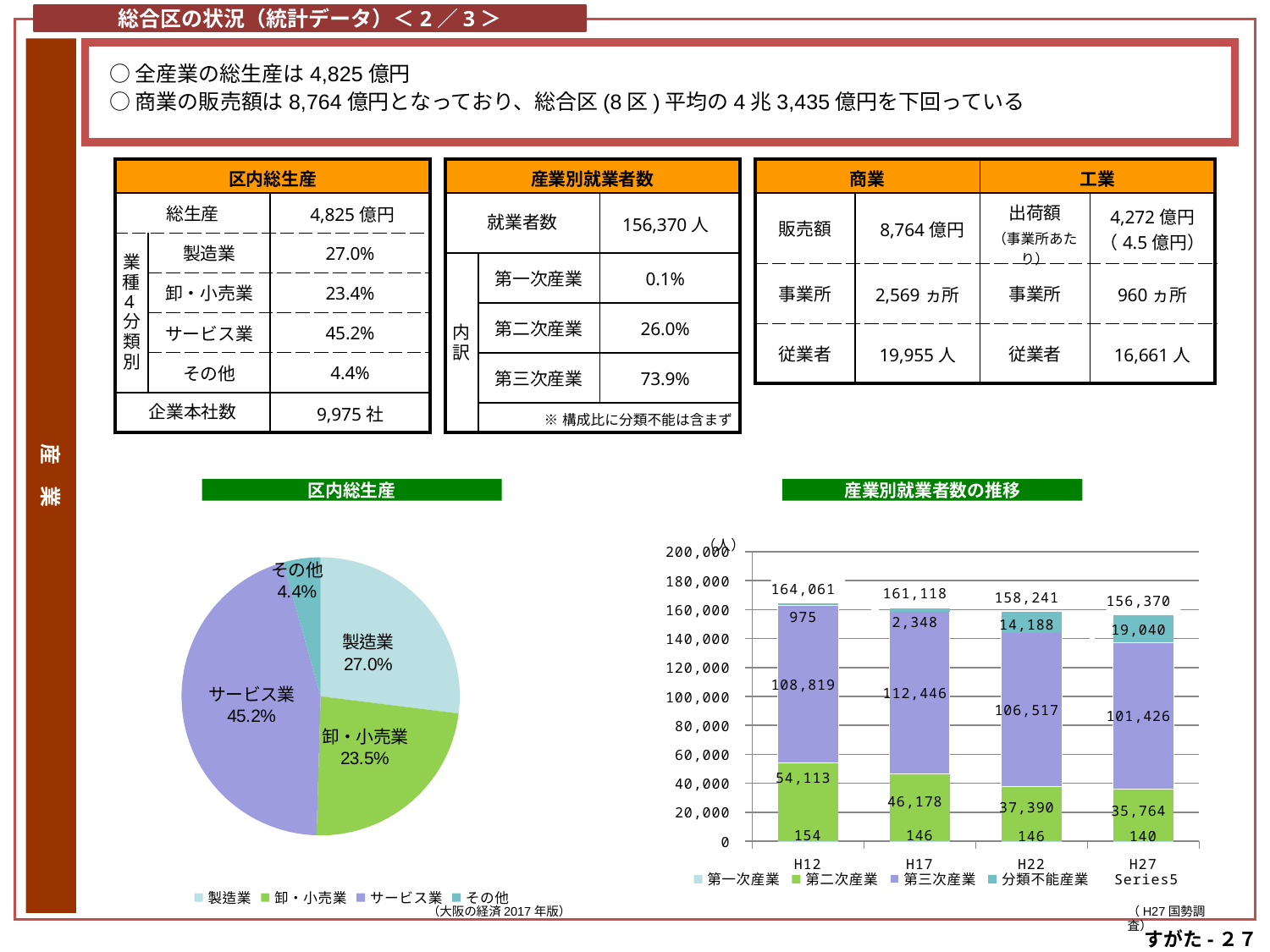
What kind of chart is the 区内総生産 chart? Pie chart In the 区内総生産 pie chart, what share does 卸・小売業 have? 23.5% In the 区内総生産 pie chart, how many slices are there? 4 How many series does the legend of the 産業別就業者数の推移 chart list? 5 In the 区内総生産 pie chart, which category has the largest share? サービス業 In the 産業別就業者数の推移 chart, which year has the highest total? H12 In the 産業別就業者数の推移 chart, do the totals rise or fall from H12 to H27? Fall In the 産業別就業者数の推移 chart, what is the total for H22? 158,241 In the 産業別就業者数の推移 chart, what is the difference between the 第二次産業 values for H12 and H27? 18,349 In the 区内総生産 pie chart, what share does サービス業 have? 45.2% In the 産業別就業者数の推移 chart, what is the value for 第三次産業 in H17? 112,446 In the 区内総生産 pie chart, which category has the smallest share? その他